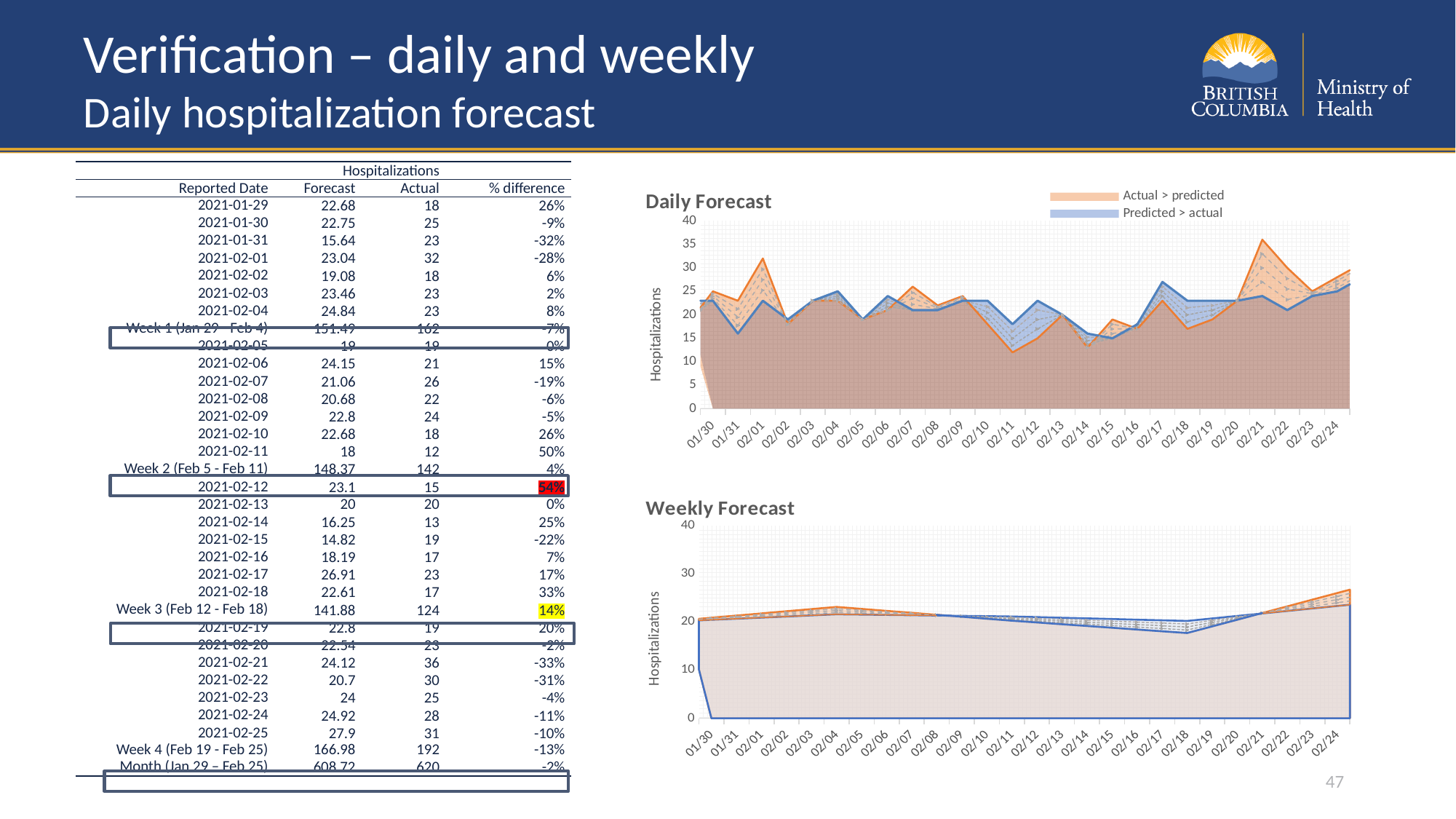
In the Daily Forecast chart, which legend entry is shown in blue? Predicted > actual In the Weekly Forecast chart, do the values rise or fall from 02/18 to 02/24? rise What is the maximum value shown on the y axis of the Weekly Forecast chart? 40 What kind of chart is the Daily Forecast chart? area chart In the Daily Forecast chart, is the lowest value on 02/11 greater or less than 15? less How many dates are shown on the x axis of the Daily Forecast chart? 26 In the Weekly Forecast chart, is the value on 02/24 greater or less than 20? greater In the Daily Forecast chart, is the peak value on 02/21 greater or less than 30? greater How many entries does the legend of the Daily Forecast chart list? 2 In the Daily Forecast chart, which legend entry is shown in orange? Actual > predicted